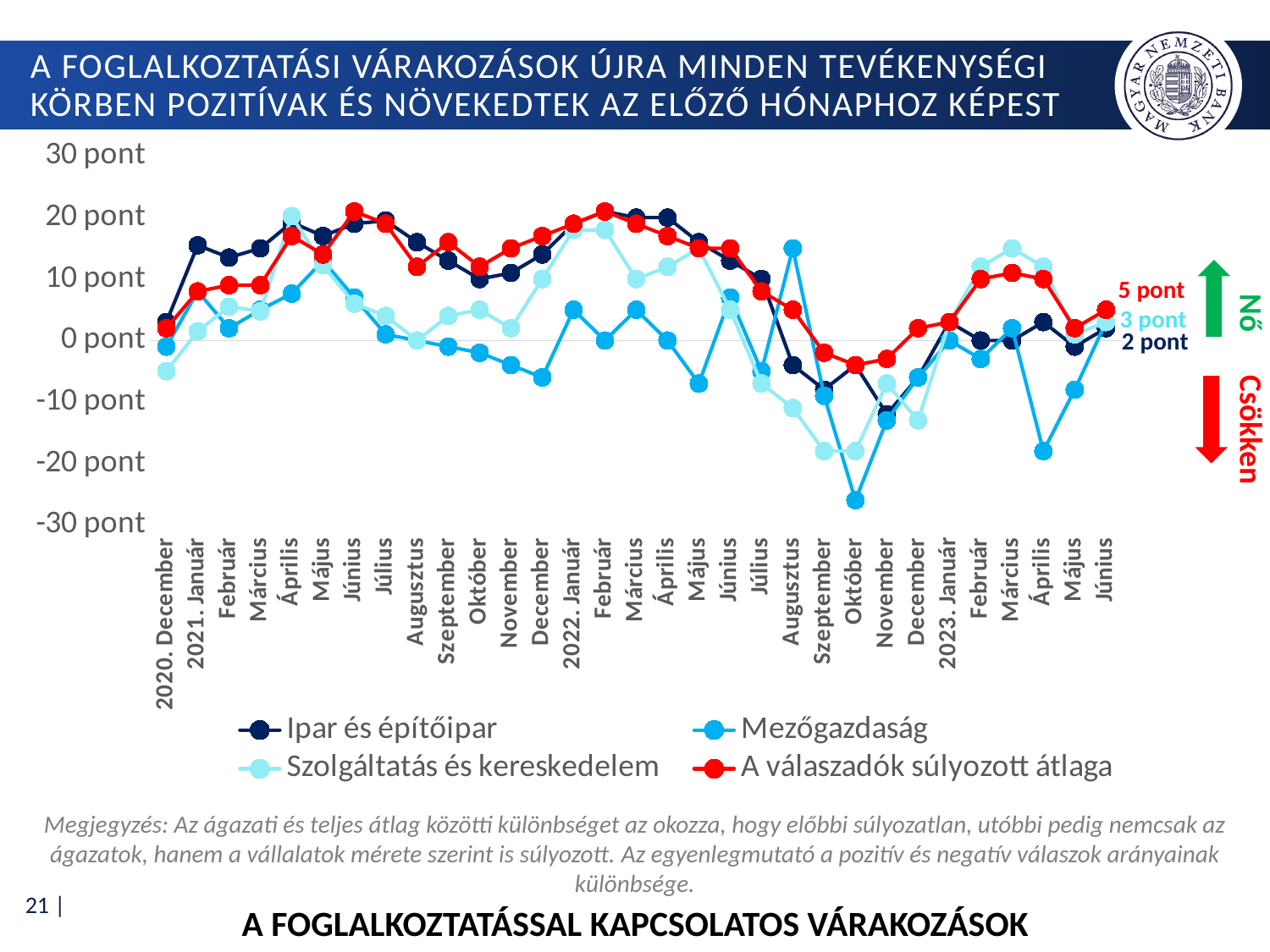
Is the value for 'Mezőgazdaság' in 2022 Augusztus greater or less than 10 pont? greater What is the value of 'A válaszadók súlyozott átlaga' in 2023 Június? 5 pont Which series has the lowest value in 2022 Október? Mezőgazdaság What colour is the line for 'A válaszadók súlyozott átlaga'? red What kind of chart is shown on the slide? line chart In 2023 Június, which is larger: 'A válaszadók súlyozott átlaga' or 'Ipar és építőipar'? A válaszadók súlyozott átlaga What is the value of 'Ipar és építőipar' in 2023 Június? 2 pont What is the value of 'Szolgáltatás és kereskedelem' in 2023 Június? 3 pont In 2023 Június, what is the difference between 'A válaszadók súlyozott átlaga' and 'Ipar és építőipar'? 3 pont Is the value for 'Mezőgazdaság' in 2022 Október greater or less than -20 pont? less How many series does the legend list? 4 How many months are shown on the x axis? 31